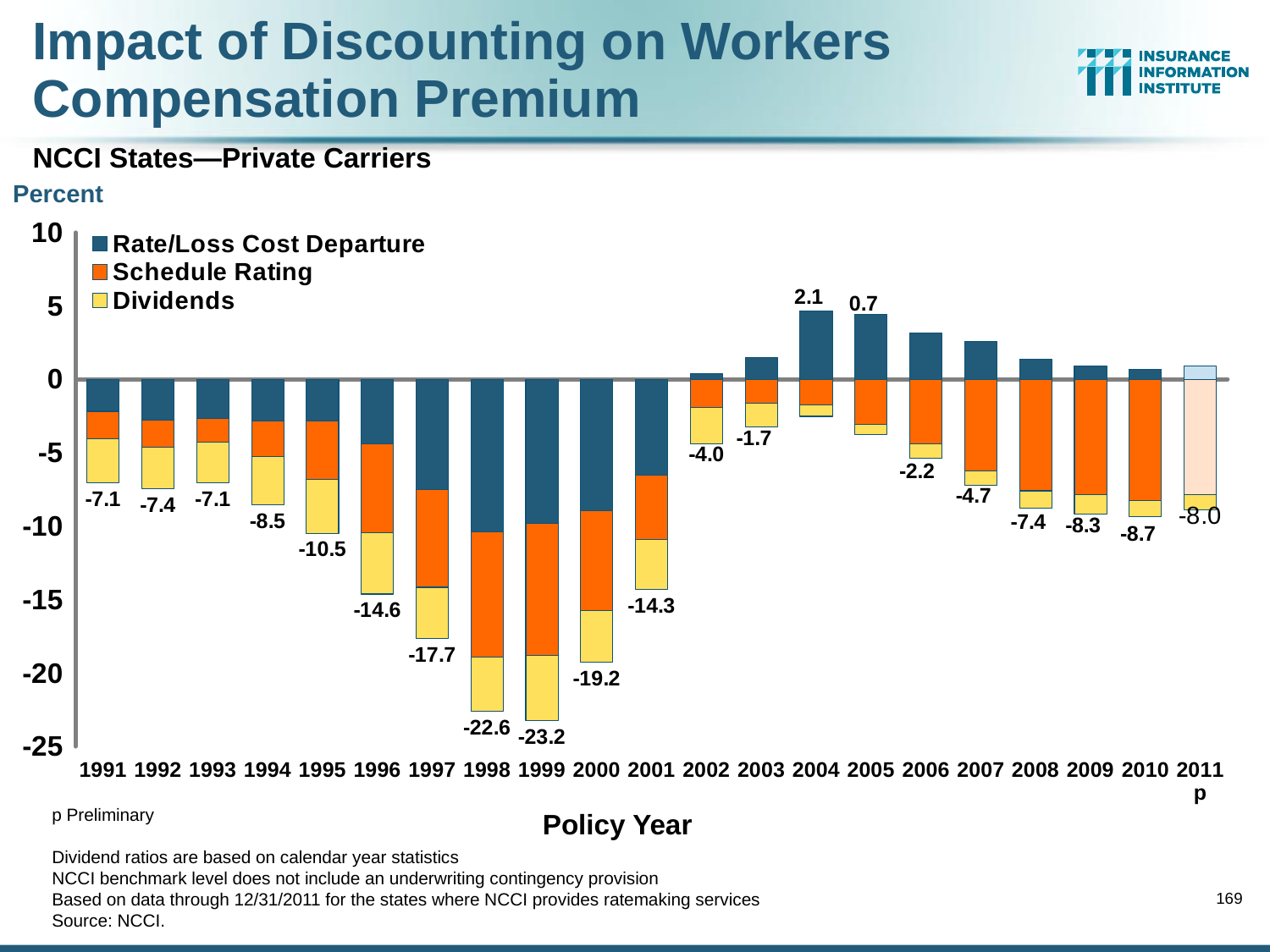
How many series does the legend list? 3 What is the labeled net value for policy year 1999? -23.2 Do the labeled net values rise or fall from 1995 to 1999? Fall What is the labeled net value for policy year 2004? 2.1 Which policy year has the lowest labeled net value? 1999 What is the difference between the labeled net values for 1998 and 1999? 0.6 How many policy years are shown on the x axis? 21 What kind of chart is shown on the slide? Stacked bar chart Which series is shown in yellow in the legend? Dividends Which policy year has the highest labeled net value? 2004 What is the labeled net value for policy year 2011p? -8.0 Which policy year has a larger labeled net value, 2002 or 2007? 2002